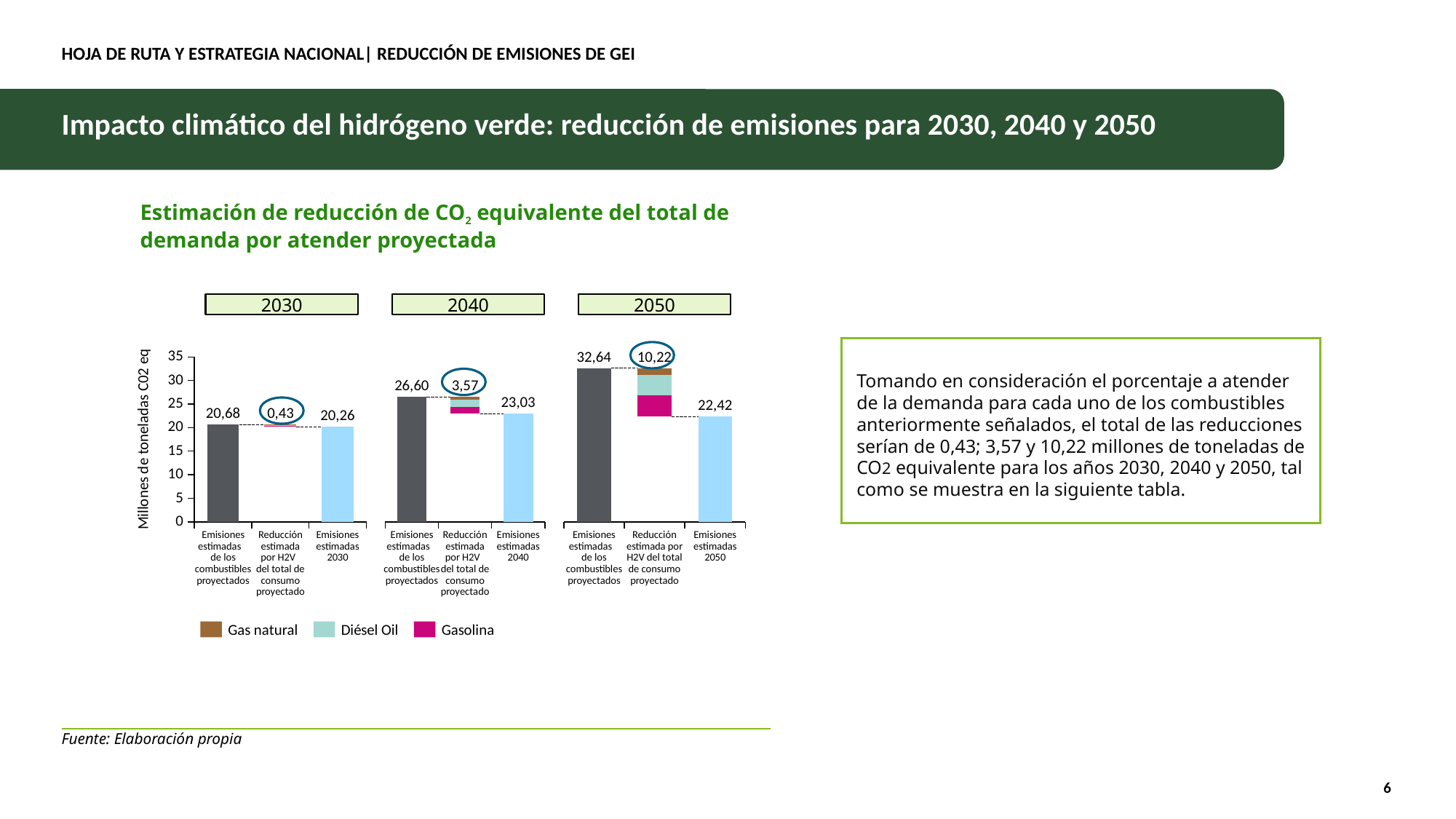
In the 2050 panel, what is the value for 'Emisiones estimadas 2050'? 22,42 Which year's panel shows the highest value for 'Emisiones estimadas de los combustibles proyectados'? 2050 Do the values for 'Reducción estimada por H2V' rise or fall from 2030 to 2050? Rise What is the difference between the projected fuel emissions (32,64) and the estimated emissions 2050 (22,42) in the 2050 panel? 10,22 What kind of chart is shown on the slide? Bar chart What is the label of the vertical axis of the chart? Millones de toneladas CO2 eq Which year's panel shows the lowest estimated reduction by H2V? 2030 Is the value for 'Emisiones estimadas de los combustibles proyectados' in the 2040 panel greater or less than 25? greater How many entries does the legend list? 3 Which is larger: the estimated emissions 2040 (23,03) or the estimated emissions 2050 (22,42)? Estimated emissions 2040 (23,03) In the 2040 panel, what is the value for 'Reducción estimada por H2V del total de consumo proyectado'? 3,57 In the 2030 panel, what is the value for 'Emisiones estimadas de los combustibles proyectados'? 20,68